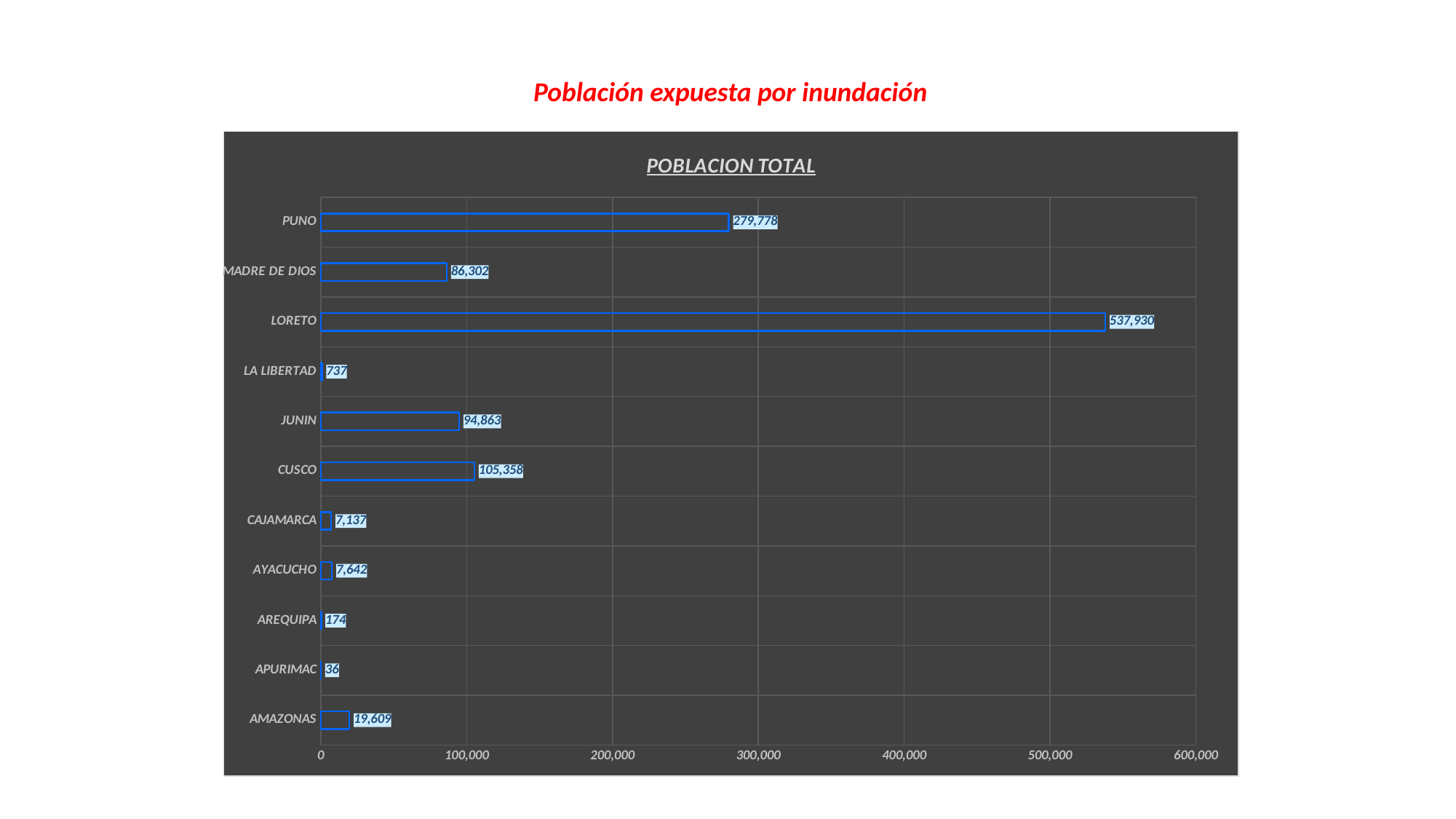
Which is larger, the value for JUNIN or the value for MADRE DE DIOS? JUNIN What is the title of the chart? POBLACION TOTAL What is the value for AMAZONAS? 19,609 Which category has the lowest value? APURIMAC How many categories are shown in the chart? 11 What kind of chart is shown on the slide? bar chart Is the value for CUSCO greater or less than 100,000? greater Which category has the highest value? LORETO What is the difference between the values for LORETO and PUNO? 258,152 What is the value for PUNO? 279,778 What is the value for LORETO? 537,930 What is the value for CUSCO? 105,358